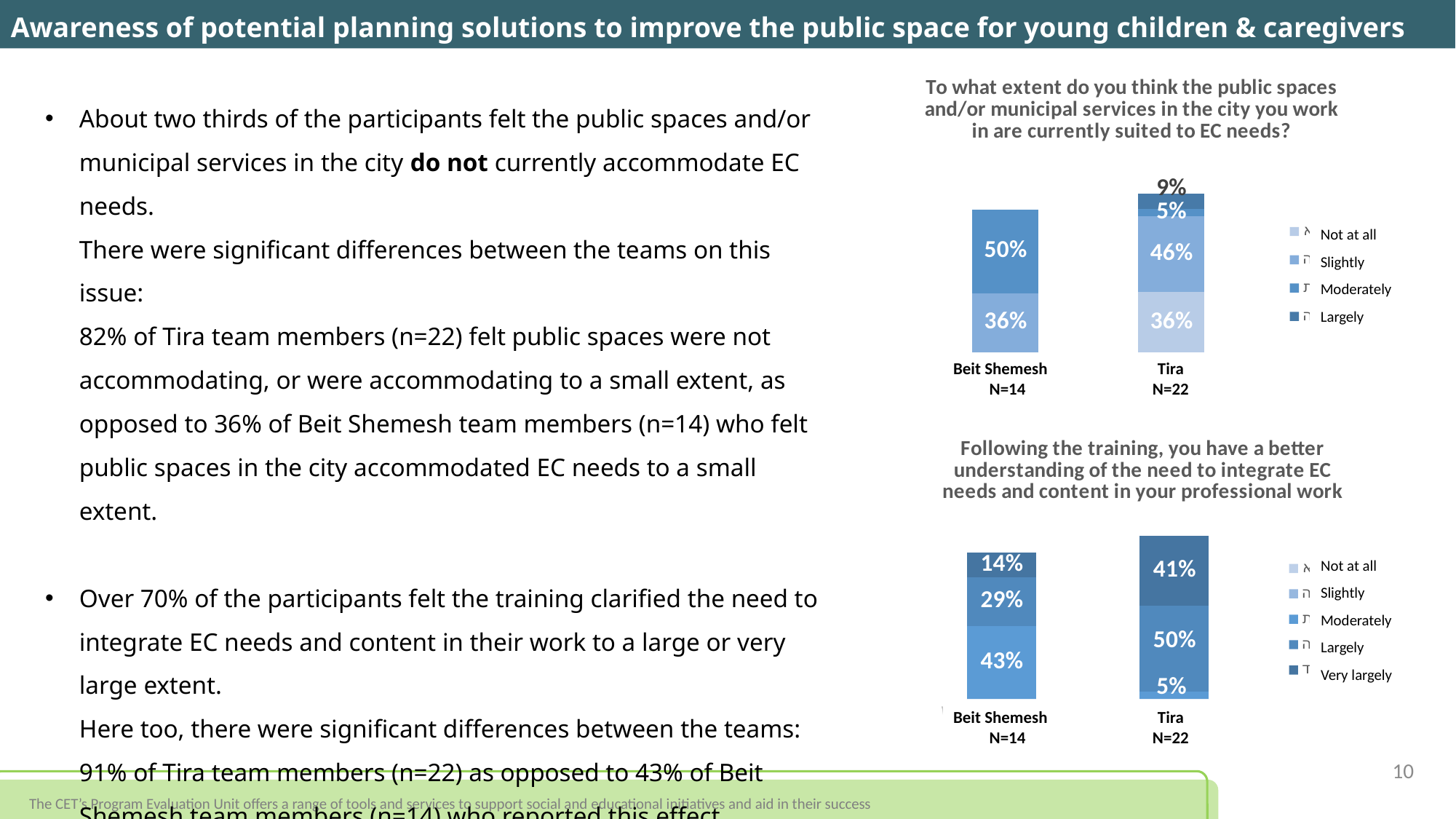
In the top chart (public spaces suited to EC needs), what is the value of the topmost segment of the Tira bar? 9% In the bottom chart (better understanding following the training), what is the value of the top segment of the Beit Shemesh bar? 14% In the bottom chart (better understanding following the training), what is the value of the bottom segment of the Tira bar? 5% In the top chart (public spaces suited to EC needs), what is the largest labeled segment of the Tira bar? 46% In the top chart (public spaces suited to EC needs), what is the value of the bottom segment of the Beit Shemesh bar? 36% How many entries does the legend list for the bottom chart (better understanding following the training)? 5 How many teams (categories) are shown on the x axis of the bottom chart (better understanding following the training)? 2 What sample size (N) is shown for Tira under the charts? N=22 In the bottom chart (better understanding following the training), which team has the larger top segment: Tira (41%) or Beit Shemesh (14%)? Tira In the bottom chart (better understanding following the training), what is the difference between the 43% and 29% segments of the Beit Shemesh bar? 14 percentage points How many entries does the legend list for the top chart (public spaces suited to EC needs)? 4 What kind of chart is used for the question 'To what extent do you think the public spaces and/or municipal services in the city you work in are currently suited to EC needs?' Stacked bar chart